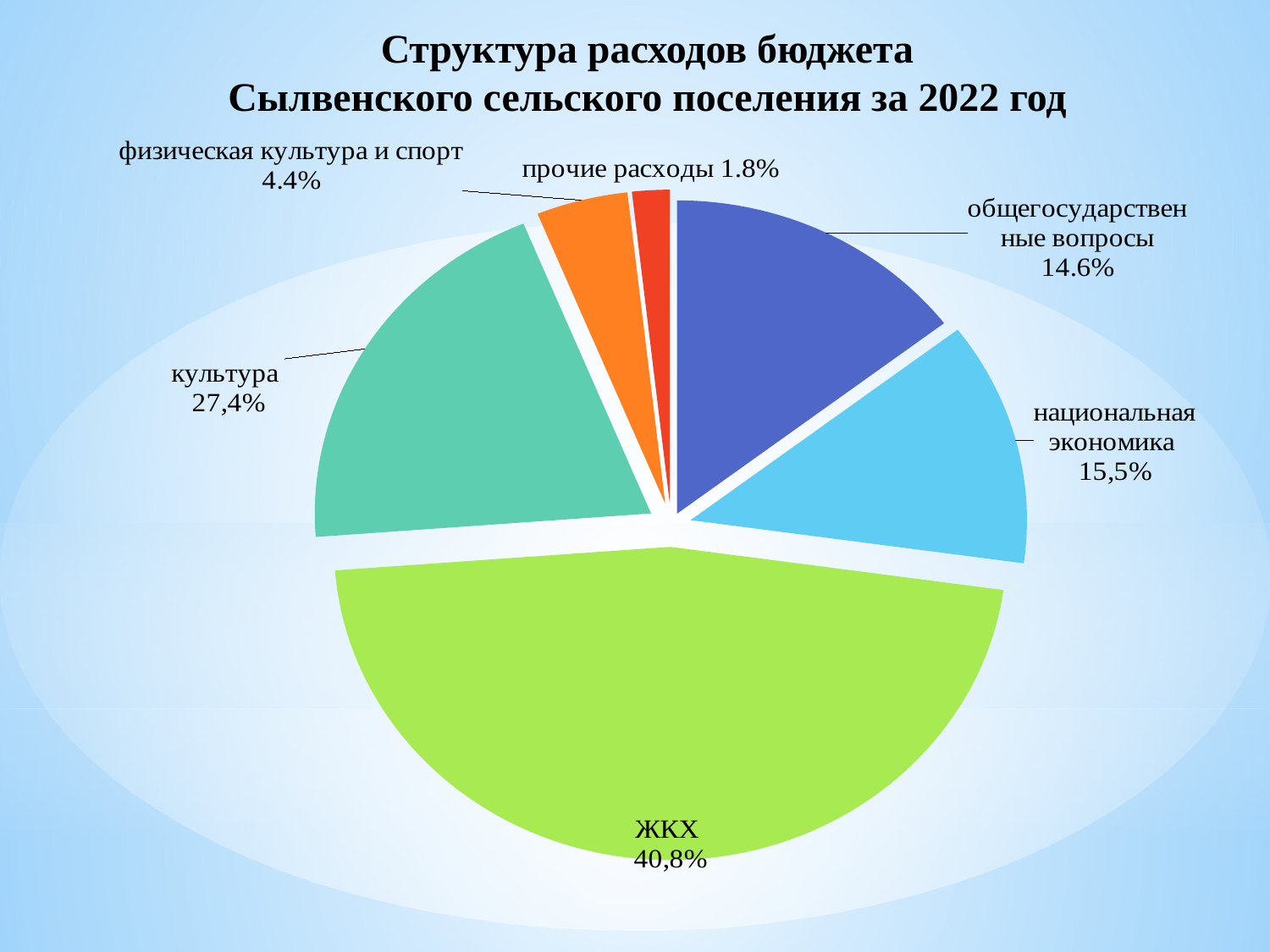
What share of the pie does ЖКХ account for? 40,8% Which is larger, the share for национальная экономика or the share for общегосударственные вопросы? национальная экономика What is the value shown for общегосударственные вопросы? 14.6% What is the difference between the shares of физическая культура и спорт and прочие расходы? 2.6% What kind of chart is shown on the slide? pie chart How many categories are shown in the pie chart? 6 What is the value shown for культура? 27,4% What is the value shown for национальная экономика? 15,5% What is the difference between the shares of ЖКХ and национальная экономика? 25,3% Which category has the smallest share of the budget expenditures? прочие расходы What is the value shown for физическая культура и спорт? 4.4% Which category has the largest share of the budget expenditures? ЖКХ